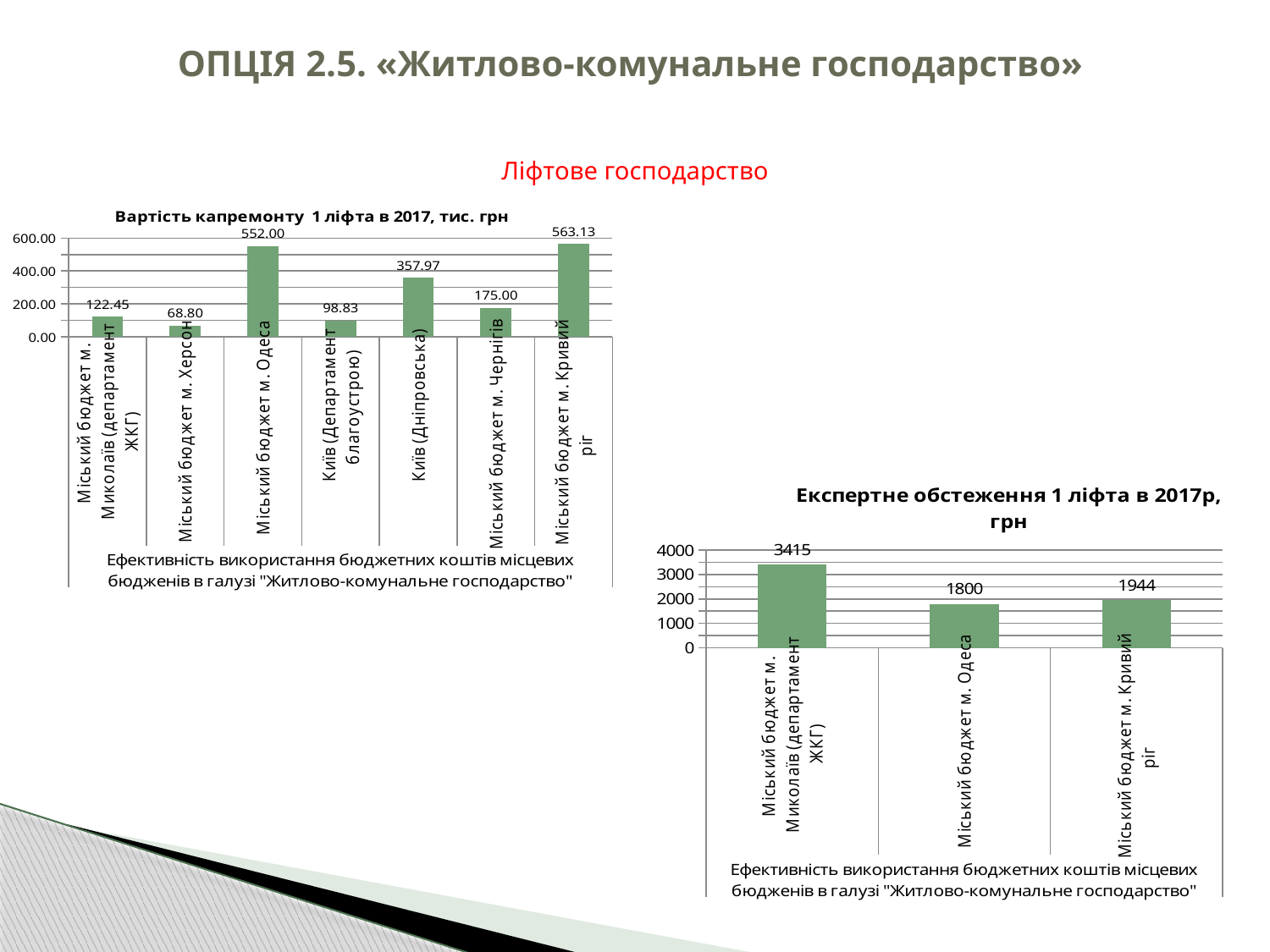
How many categories are shown in the chart 'Вартість капремонту 1 ліфта в 2017, тис. грн'? 7 In the chart 'Експертне обстеження 1 ліфта в 2017р, грн', what is the difference between the values for Міський бюджет м. Кривий ріг and Міський бюджет м. Одеса? 144 In the chart 'Вартість капремонту 1 ліфта в 2017, тис. грн', what is the value for Київ (Дніпровська)? 357.97 In the chart 'Вартість капремонту 1 ліфта в 2017, тис. грн', which is larger: the value for Міський бюджет м. Миколаїв (департамент ЖКГ) or for Київ (Департамент благоустрою)? Міський бюджет м. Миколаїв (департамент ЖКГ) In the chart 'Вартість капремонту 1 ліфта в 2017, тис. грн', what is the difference between the values for Міський бюджет м. Чернігів and Міський бюджет м. Херсон? 106.20 In the chart 'Вартість капремонту 1 ліфта в 2017, тис. грн', which category has the lowest value? Міський бюджет м. Херсон In the chart 'Вартість капремонту 1 ліфта в 2017, тис. грн', what is the value for Міський бюджет м. Одеса? 552.00 In the chart 'Експертне обстеження 1 ліфта в 2017р, грн', what is the value for Міський бюджет м. Одеса? 1800 How many categories are shown in the chart 'Експертне обстеження 1 ліфта в 2017р, грн'? 3 In the chart 'Експертне обстеження 1 ліфта в 2017р, грн', which category has the highest value? Міський бюджет м. Миколаїв (департамент ЖКГ) What type of chart is 'Експертне обстеження 1 ліфта в 2017р, грн'? Bar chart In the chart 'Вартість капремонту 1 ліфта в 2017, тис. грн', which category has the highest value? Міський бюджет м. Кривий ріг